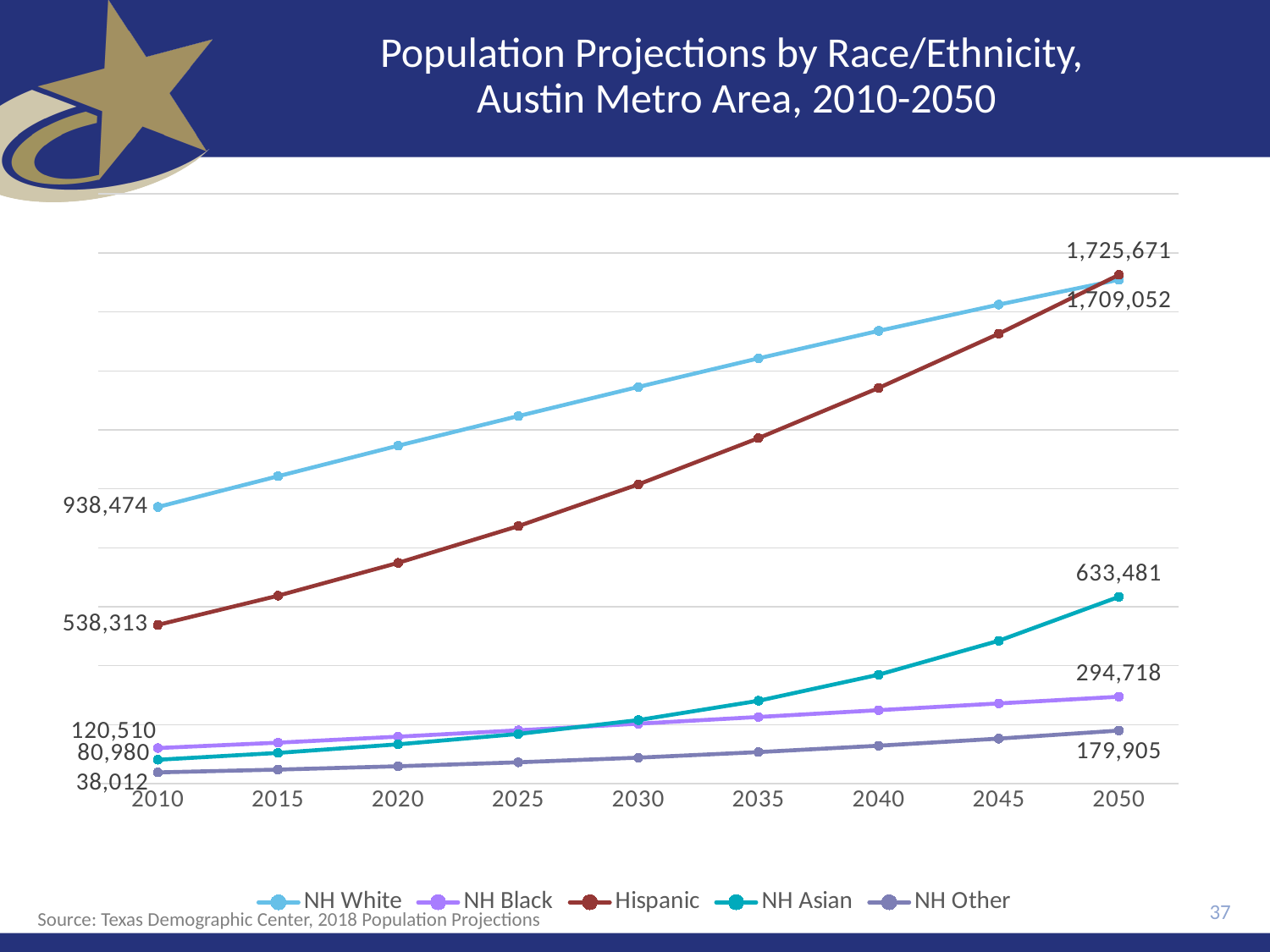
What is the difference between the Hispanic and NH White projected populations in 2050? 16,619 By how much is the NH Asian population projected to grow from 2010 to 2050? 552,501 What kind of chart is shown on the slide? Line chart In 2010, which is larger: the NH Black population or the NH Asian population? NH Black How many series does the legend list? 5 What is the projected Hispanic population in the Austin Metro Area in 2050? 1,725,671 Does the NH Other population rise or fall from 2010 to 2050? Rise Which race/ethnicity group has the highest projected population in 2050? Hispanic What is the projected NH Asian population in 2050? 633,481 What is the NH Other population value shown for 2010? 38,012 Which race/ethnicity group has the lowest population in 2010? NH Other What is the projected NH White population in the Austin Metro Area in 2010? 938,474